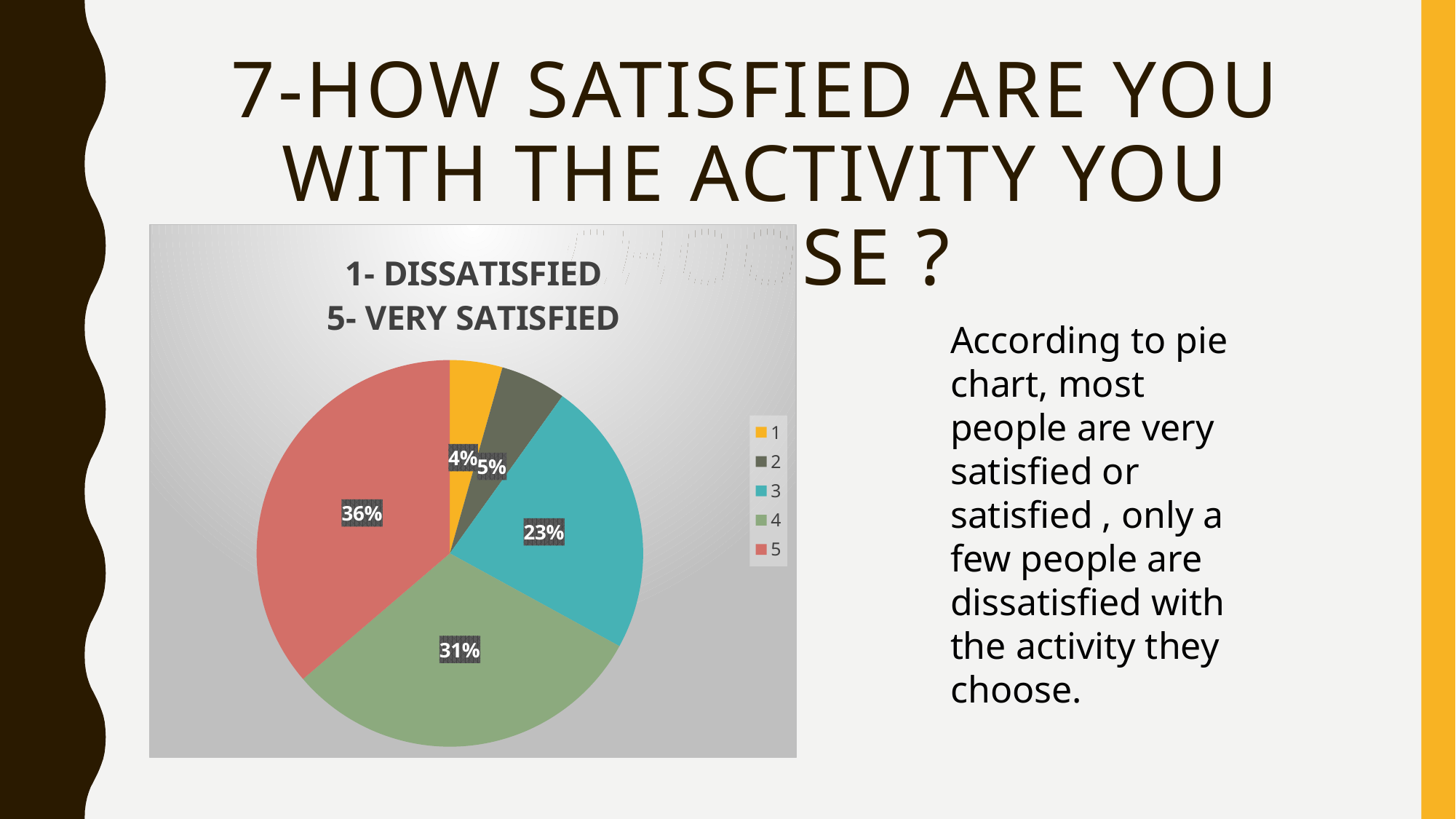
How many categories does the legend list? 5 What kind of chart is shown on the slide? pie chart What share of the pie does category 5 have? 36% What share of the pie does category 2 have? 5% What share of the pie does category 3 have? 23% What colour is the slice for category 3? teal/blue Which category has the smallest slice of the pie? 1 Which is larger, the slice for category 3 or the slice for category 4? 4 Which category has the largest slice of the pie? 5 What is the difference in percentage points between category 5 and category 4? 5